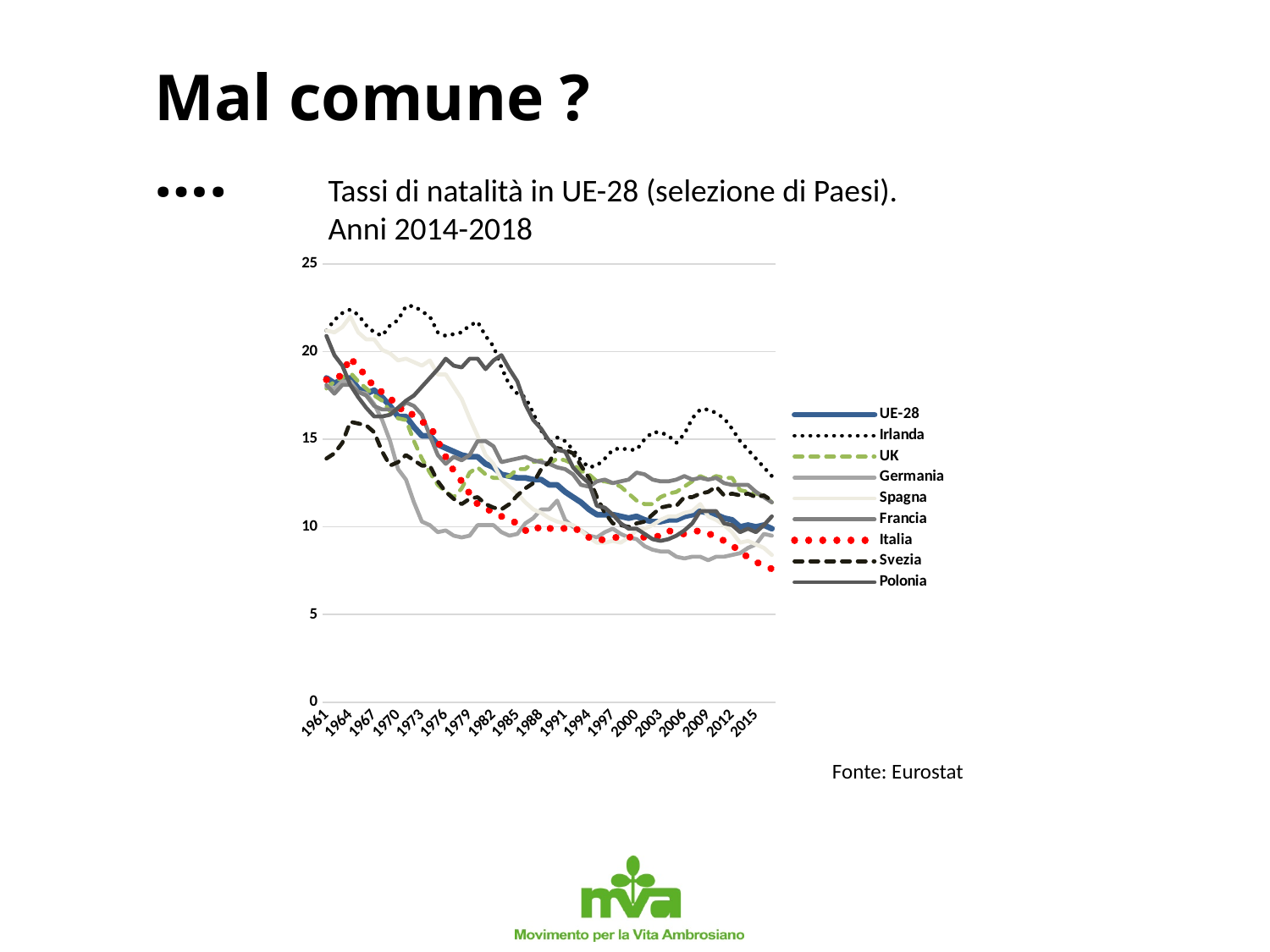
How many series does the legend list? 9 Is the value for Germania in 2009 greater or less than 10? less Is the value for Italia in 2015 greater or less than 10? less Is the value for Irlanda in 1961 greater or less than 20? greater Does the Italia series rise or fall overall from 1961 to 2015? fall In 2015, which is larger: the value for Irlanda or the value for Italia? Irlanda What is the title of the chart? Tassi di natalità in UE-28 (selezione di Paesi). Anni 2014-2018 Which series is drawn as a red dotted line? Italia What kind of chart is shown on the slide? line chart